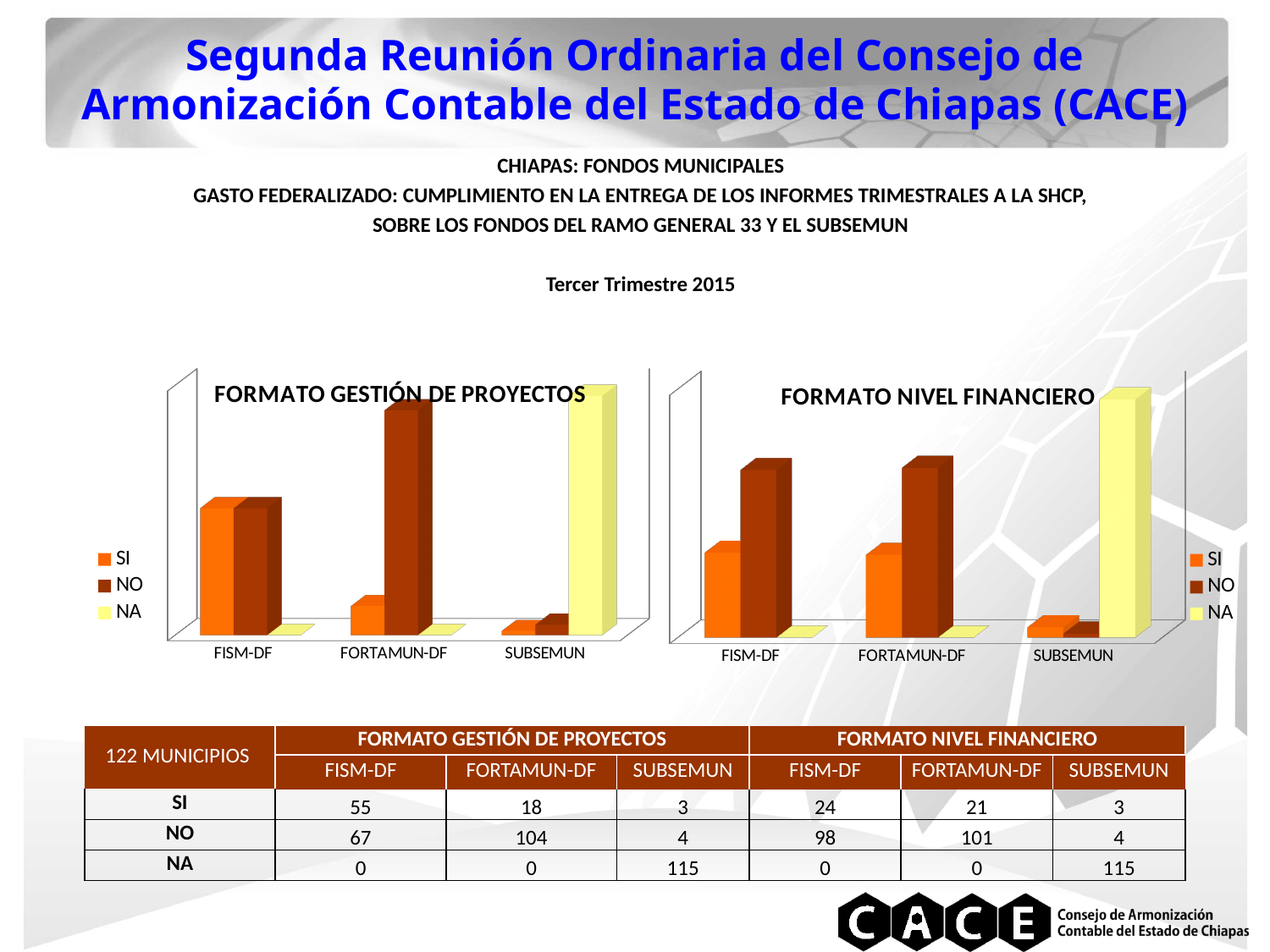
In the FORMATO GESTIÓN DE PROYECTOS chart, which category has the highest NA value? SUBSEMUN In the FORMATO GESTIÓN DE PROYECTOS chart, does the SI series rise or fall from FISM-DF to SUBSEMUN? fall In the FORMATO NIVEL FINANCIERO chart, which category has the lowest SI value? SUBSEMUN How many categories are shown on the x axis of the FORMATO NIVEL FINANCIERO chart? 3 What kind of chart is the FORMATO GESTIÓN DE PROYECTOS chart? bar chart How many series does the legend of the FORMATO GESTIÓN DE PROYECTOS chart list? 3 What is the title of the chart on the right side of the slide? FORMATO NIVEL FINANCIERO